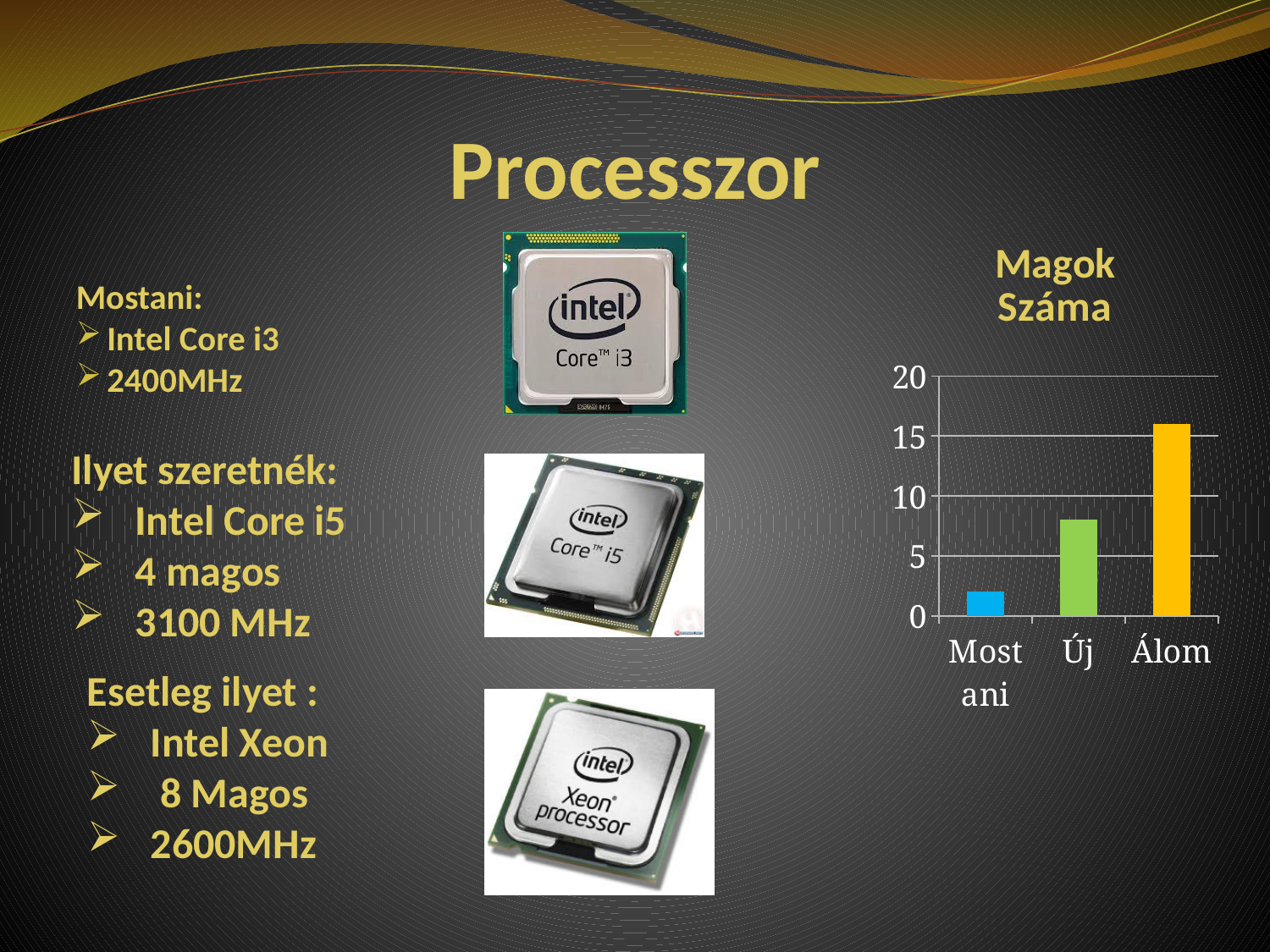
Do the bars in the "Magok Száma" chart rise or fall from left to right? rise How many categories are shown on the x axis of the "Magok Száma" chart? 3 In the "Magok Száma" chart, is the value for Álom greater or less than 15? greater In the "Magok Száma" chart, is the value for Új greater or less than 5? greater Which category has the lowest bar in the "Magok Száma" chart? Mostani In the "Magok Száma" chart, which is larger, the value for Új or the value for Mostani? Új What is the title of the chart on the right side of the slide? Magok Száma Which category has the highest bar in the "Magok Száma" chart? Álom What kind of chart is shown under the title "Magok Száma"? bar chart What colour is the bar for Álom in the "Magok Száma" chart? orange In the "Magok Száma" chart, is the value for Új greater or less than 10? less